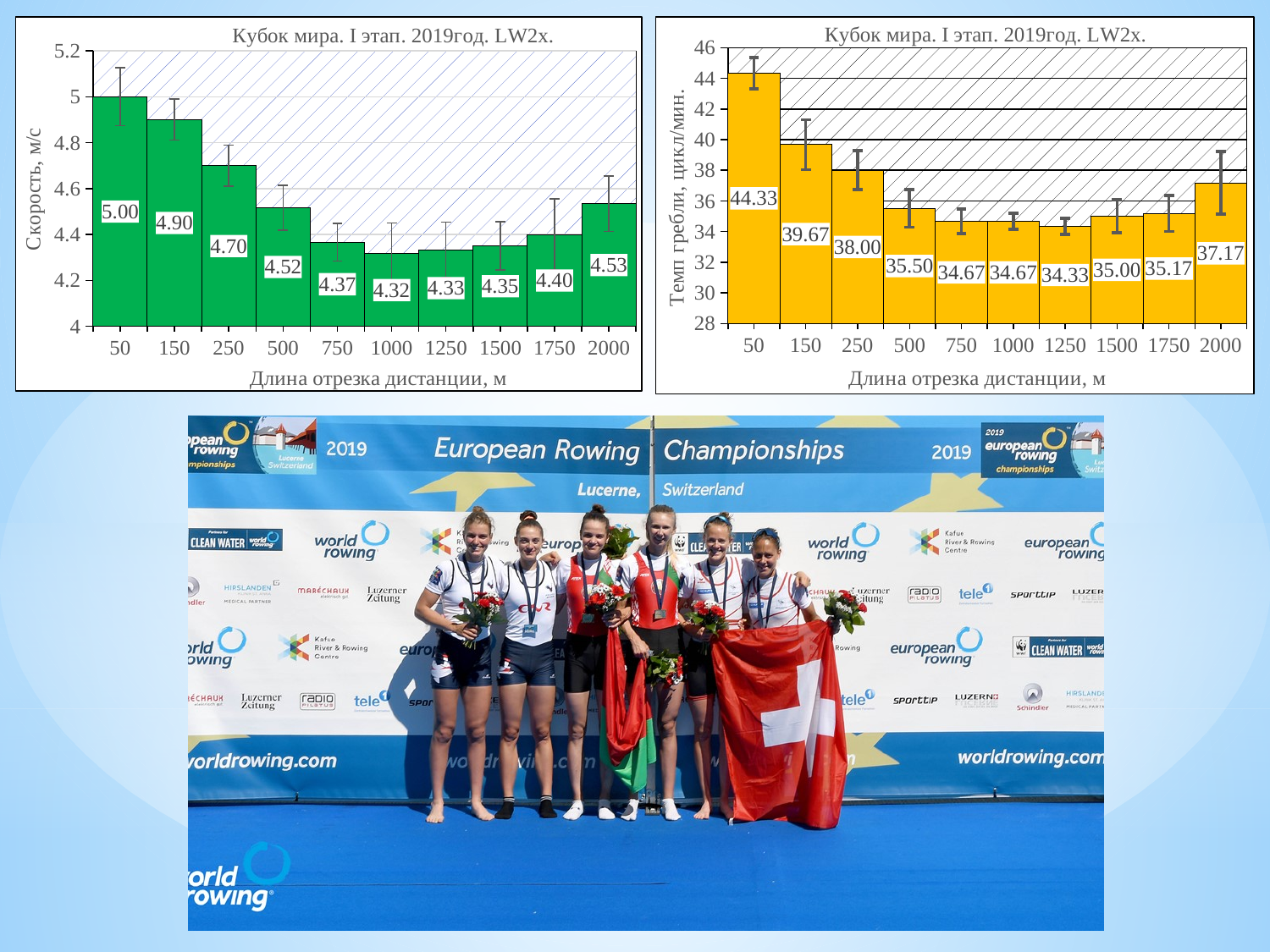
In the right chart (stroke rate, цикл/мин), what is the difference between the values for 50 m and 150 m? 4.66 In the left chart (speed, м/с), what is the value for the 1000 m segment? 4.32 In the left chart (speed, м/с), what is the value for the 50 m segment? 5.00 How many segments (bars) are shown in the right chart (stroke rate, цикл/мин)? 10 In the right chart (stroke rate, цикл/мин), which segment has the lowest value? 1250 What is the title of the right chart (stroke rate, цикл/мин)? Кубок мира. I этап. 2019год. LW2x. What type of chart is the left chart (speed, м/с)? Bar chart In the left chart (speed, м/с), what is the difference between the values for 50 m and 2000 m? 0.47 In the left chart (speed, м/с), which segment has the highest value? 50 In the right chart (stroke rate, цикл/мин), what is the value for the 2000 m segment? 37.17 In the left chart (speed, м/с), which is larger: the value for 500 m or the value for 2000 m? 2000 m In the right chart (stroke rate, цикл/мин), what is the value for the 500 m segment? 35.50